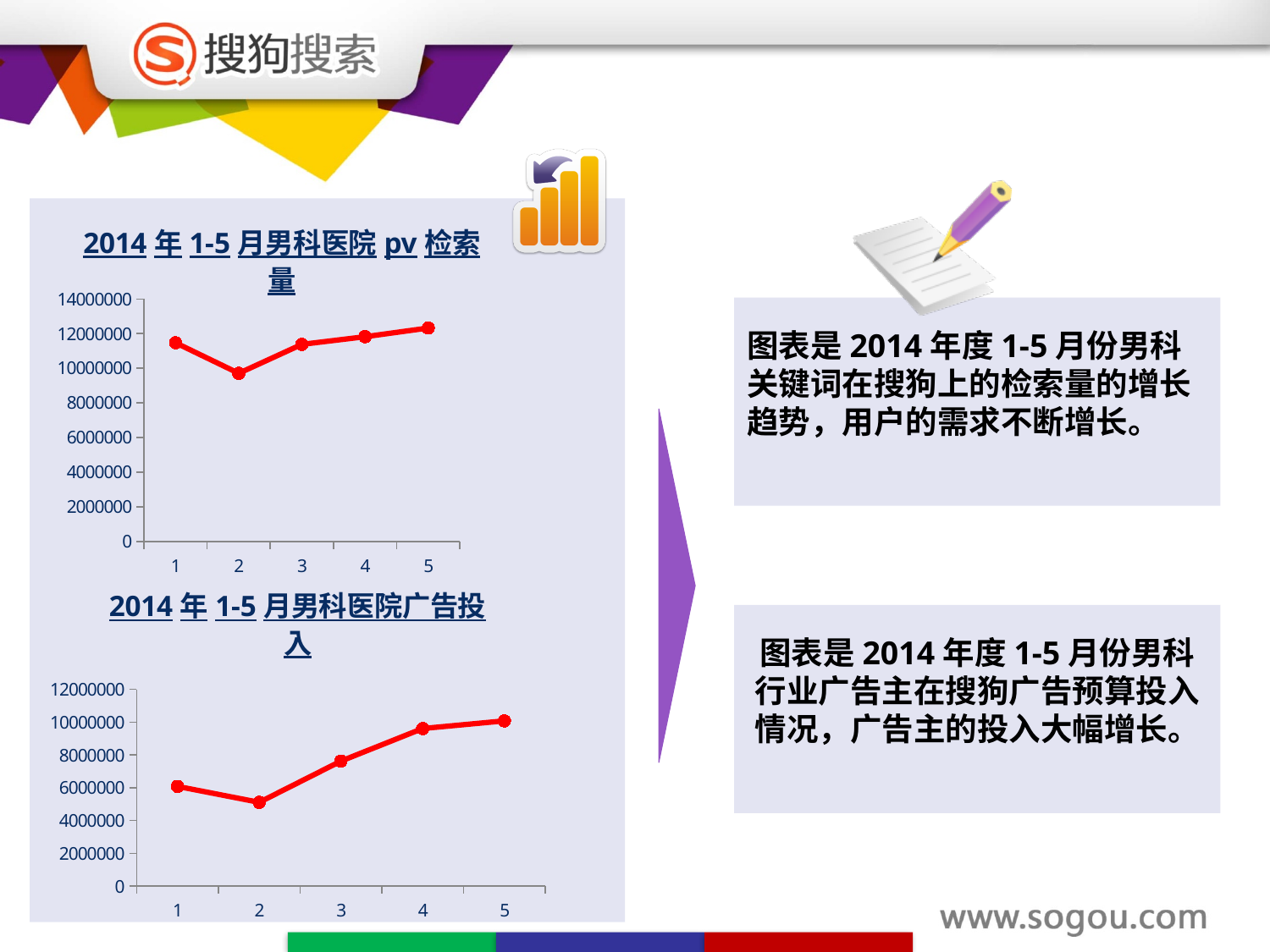
In the top chart (2014年1-5月男科医院pv检索量), is the value for month 2 greater or less than 10000000? less What kind of chart is the bottom chart titled 2014年1-5月男科医院广告投入? line chart How many data points are plotted in the bottom chart (2014年1-5月男科医院广告投入)? 5 In the bottom chart (2014年1-5月男科医院广告投入), which month has the lowest value? 2 In the top chart (2014年1-5月男科医院pv检索量), which month has the highest value? 5 In the top chart (2014年1-5月男科医院pv检索量), which month has the lowest value? 2 In the bottom chart (2014年1-5月男科医院广告投入), do the values generally rise or fall from month 2 to month 5? rise In the bottom chart (2014年1-5月男科医院广告投入), is the value for month 4 greater or less than 8000000? greater In the bottom chart (2014年1-5月男科医院广告投入), which month has the highest value? 5 What kind of chart is the top chart titled 2014年1-5月男科医院pv检索量? line chart In the bottom chart (2014年1-5月男科医院广告投入), which is larger, the value for month 1 or the value for month 3? month 3 How many data points are plotted in the top chart (2014年1-5月男科医院pv检索量)? 5